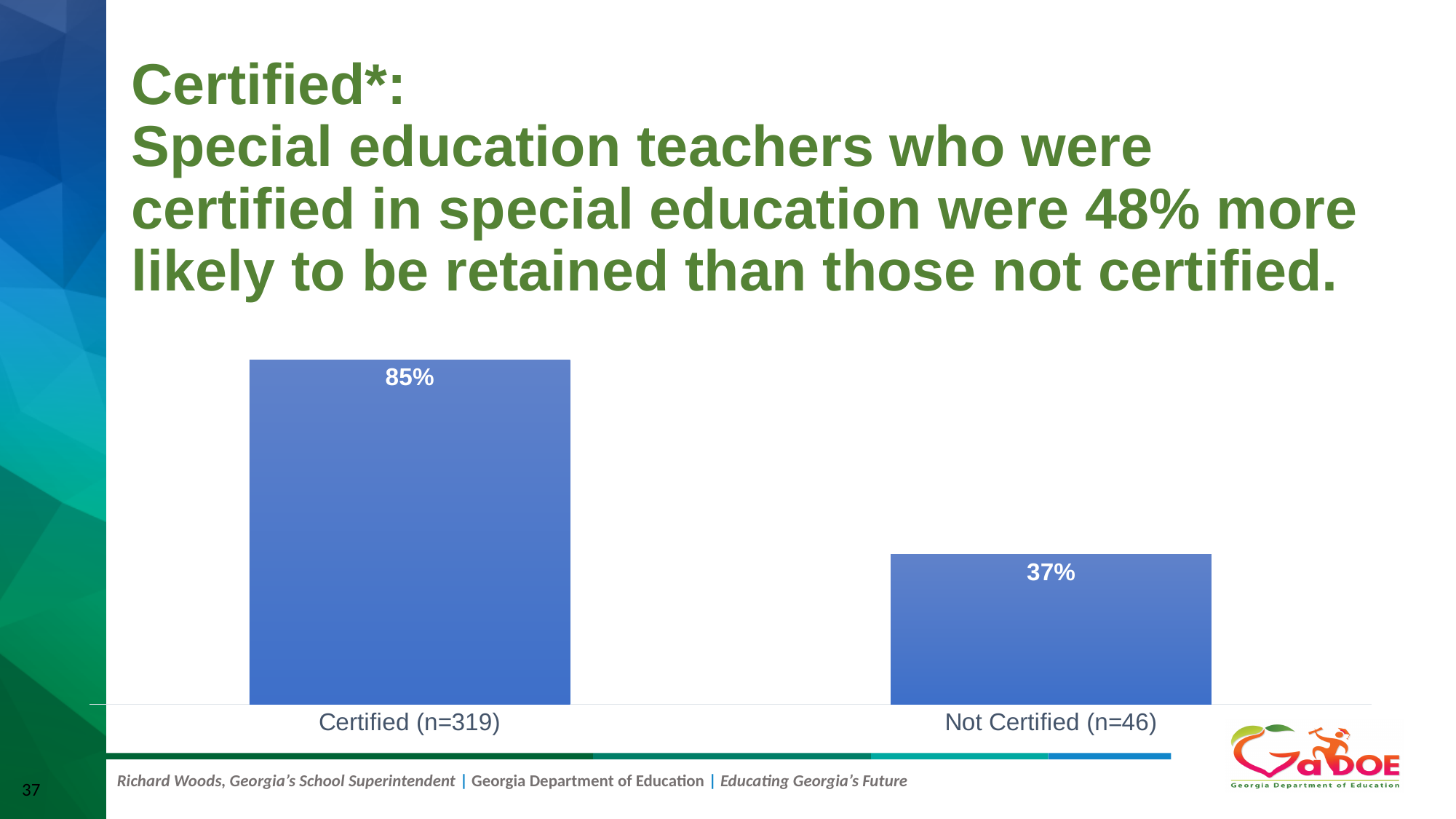
Which category has the lowest value? Not Certified (n=46) What is the sample size shown in the label for the Certified category? 319 What is the difference between the values for Certified (n=319) and Not Certified (n=46)? 48% What kind of chart is shown on the slide? Bar chart What colour are the bars in the chart? Blue Which is larger, the value for Certified (n=319) or Not Certified (n=46)? Certified (n=319) Which category has the highest value? Certified (n=319) Do the values rise or fall from left to right across the categories? Fall What is the value for Not Certified (n=46)? 37% What is the value for Certified (n=319)? 85% How many categories are shown in the chart? 2